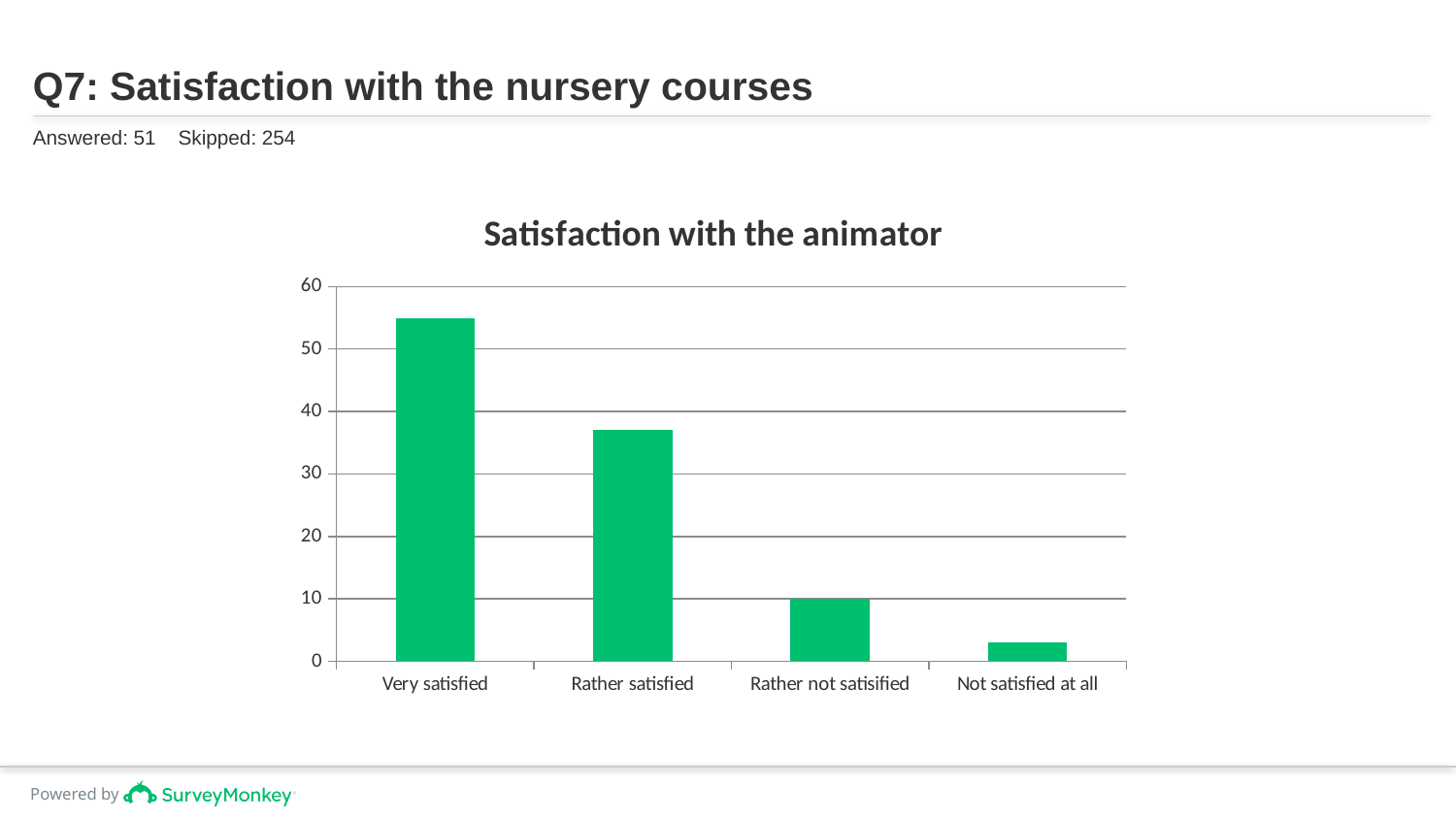
Is the value for Rather satisfied greater or less than 40? less What kind of chart is shown on the slide? bar chart What is the title of the chart? Satisfaction with the animator Which category has the highest value? Very satisfied Which category has the lowest value? Not satisfied at all Is the value for Very satisfied greater or less than 50? greater Do the values rise or fall moving from left to right along the x axis? fall How many categories are shown on the x axis of the chart? 4 Which is larger, the value for Rather satisfied or the value for Rather not satisified? Rather satisfied What is the value for Rather not satisified? 10 Is the value for Not satisfied at all greater or less than 10? less